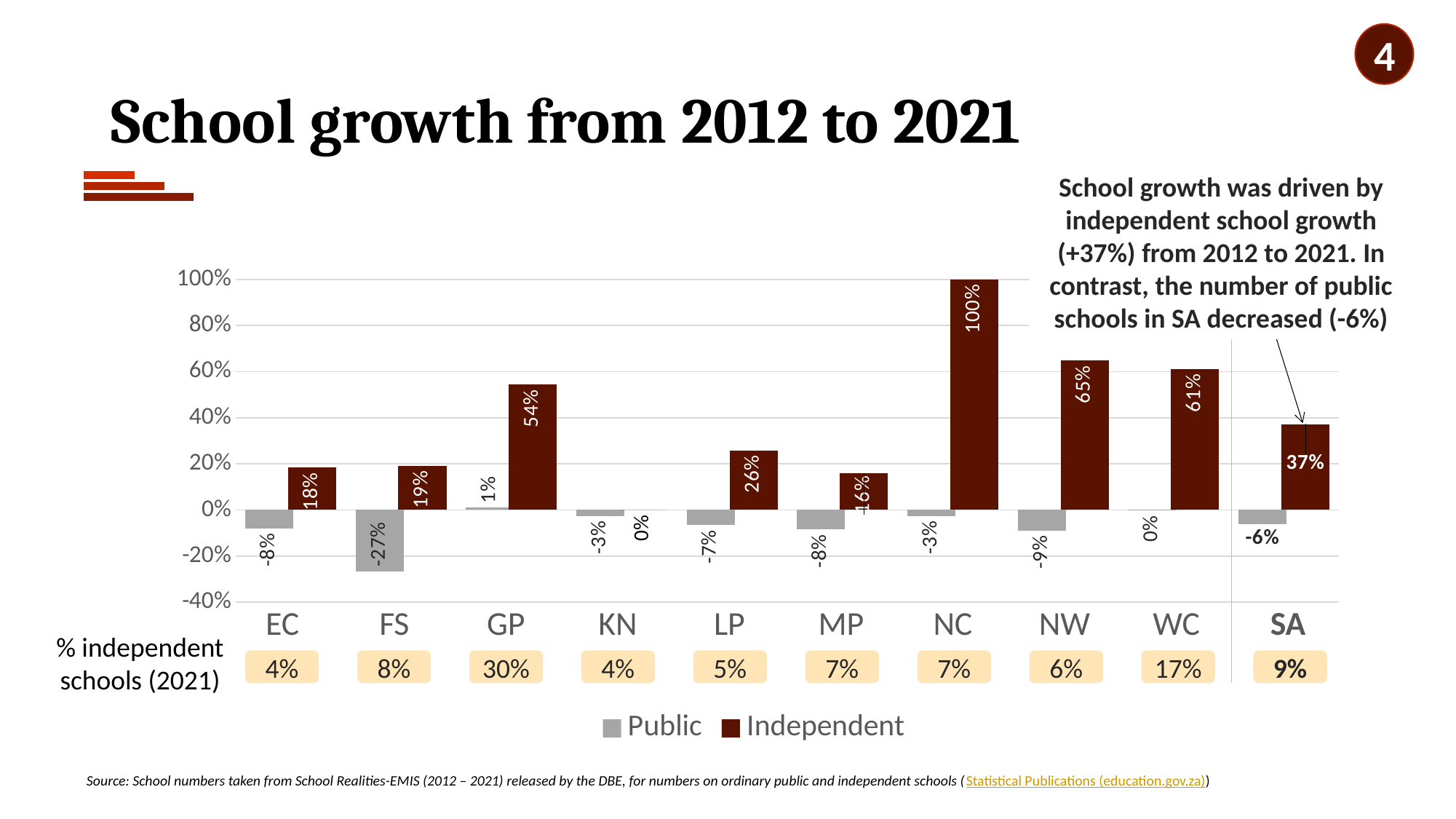
What is the Independent school growth value for NC? 100% Which province has the lowest Public school growth? FS What is the Independent school growth value for GP? 54% Which is larger, the Independent growth for EC or for LP? LP Which province has the highest Independent school growth? NC What is the Public school growth value for SA? -6% What kind of chart is shown on the slide? Bar chart What is the % independent schools (2021) value shown for GP? 30% What is the difference between the Independent growth for NW and WC? 4% What is the Public school growth value for FS? -27% How many series does the legend list? 2 How many provinces/categories are shown on the x axis of the chart? 10